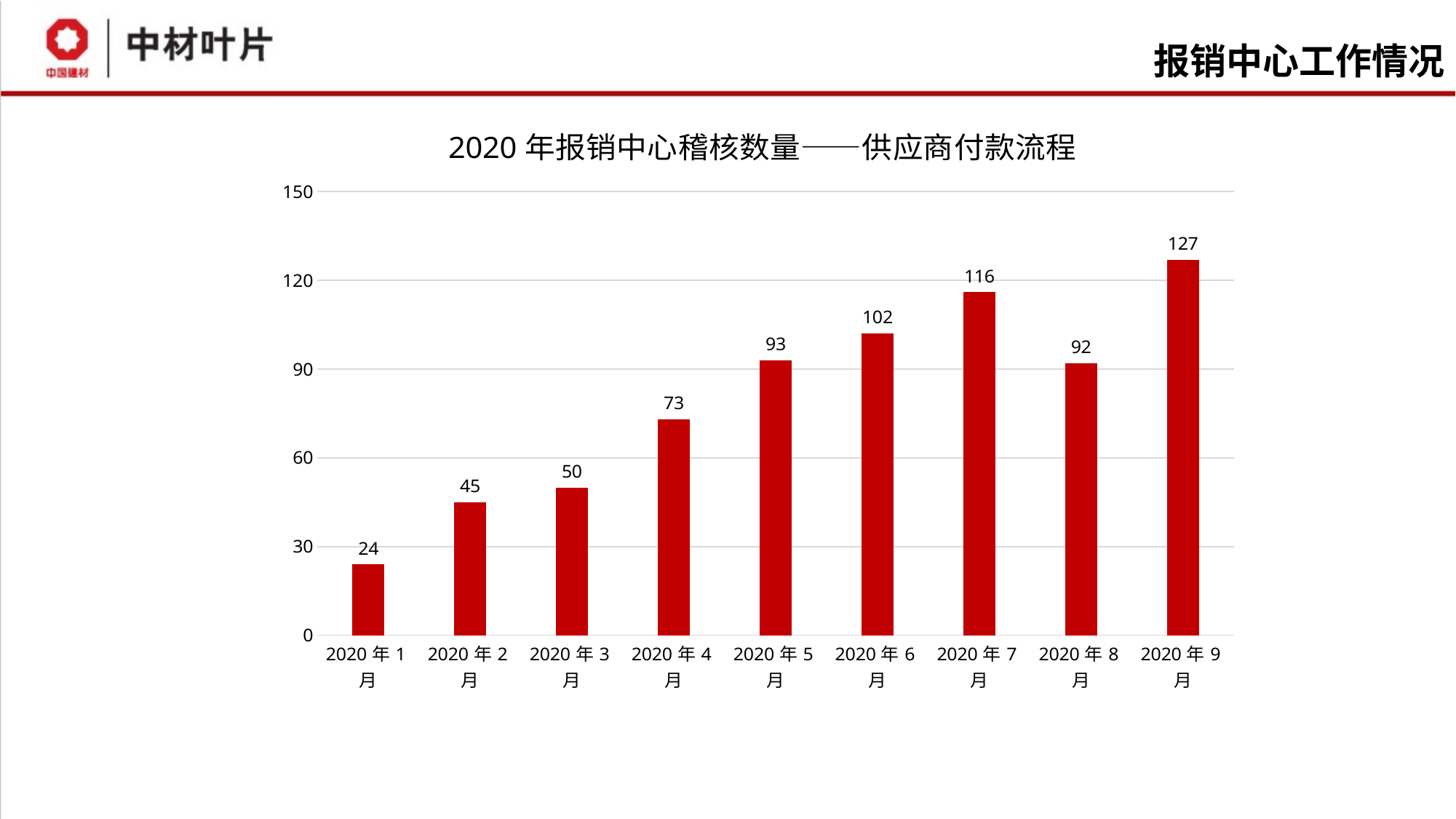
Which is larger, the value for 2020年6月 or the value for 2020年8月? 2020年6月 Which month has the highest value? 2020年9月 What is the difference between the values for 2020年9月 and 2020年8月? 35 Is the value for 2020年7月 greater or less than 90? greater What kind of chart is shown on the slide? bar chart Which month has the lowest value? 2020年1月 What is the difference between the values for 2020年4月 and 2020年3月? 23 What is the value for 2020年8月? 92 How many months are shown on the x axis? 9 What is the value for 2020年1月? 24 What is the title of the chart? 2020年报销中心稽核数量——供应商付款流程 What is the value for 2020年5月? 93